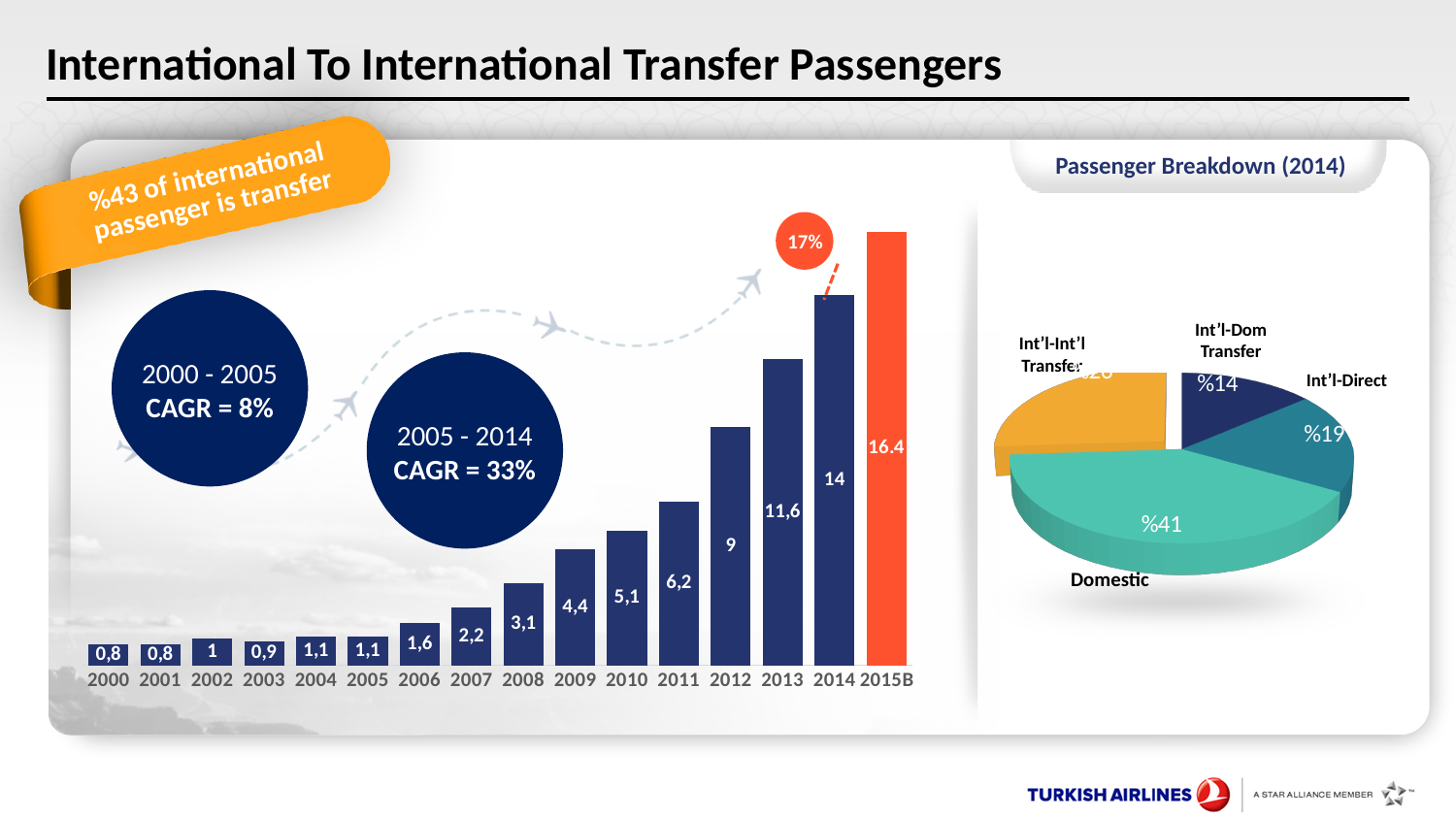
In the bar chart, what is the value for 2014? 14 In the bar chart, which year has the highest value? 2015B How many bars are shown in the bar chart? 16 In the bar chart, what is the difference between the values for 2013 and 2012? 2,6 In the Passenger Breakdown (2014) pie chart, what share is Int'l-Direct? %19 In the bar chart, do the values generally rise or fall from 2005 to 2014? rise What kind of chart is the Passenger Breakdown (2014) chart? pie chart In the bar chart, which is larger, the value for 2010 or the value for 2011? 2011 In the bar chart, what is the value for 2008? 3,1 In the bar chart, what is the value for 2015B? 16.4 In the bar chart, what is the value for 2003? 0,9 In the Passenger Breakdown (2014) pie chart, what share is Domestic? %41